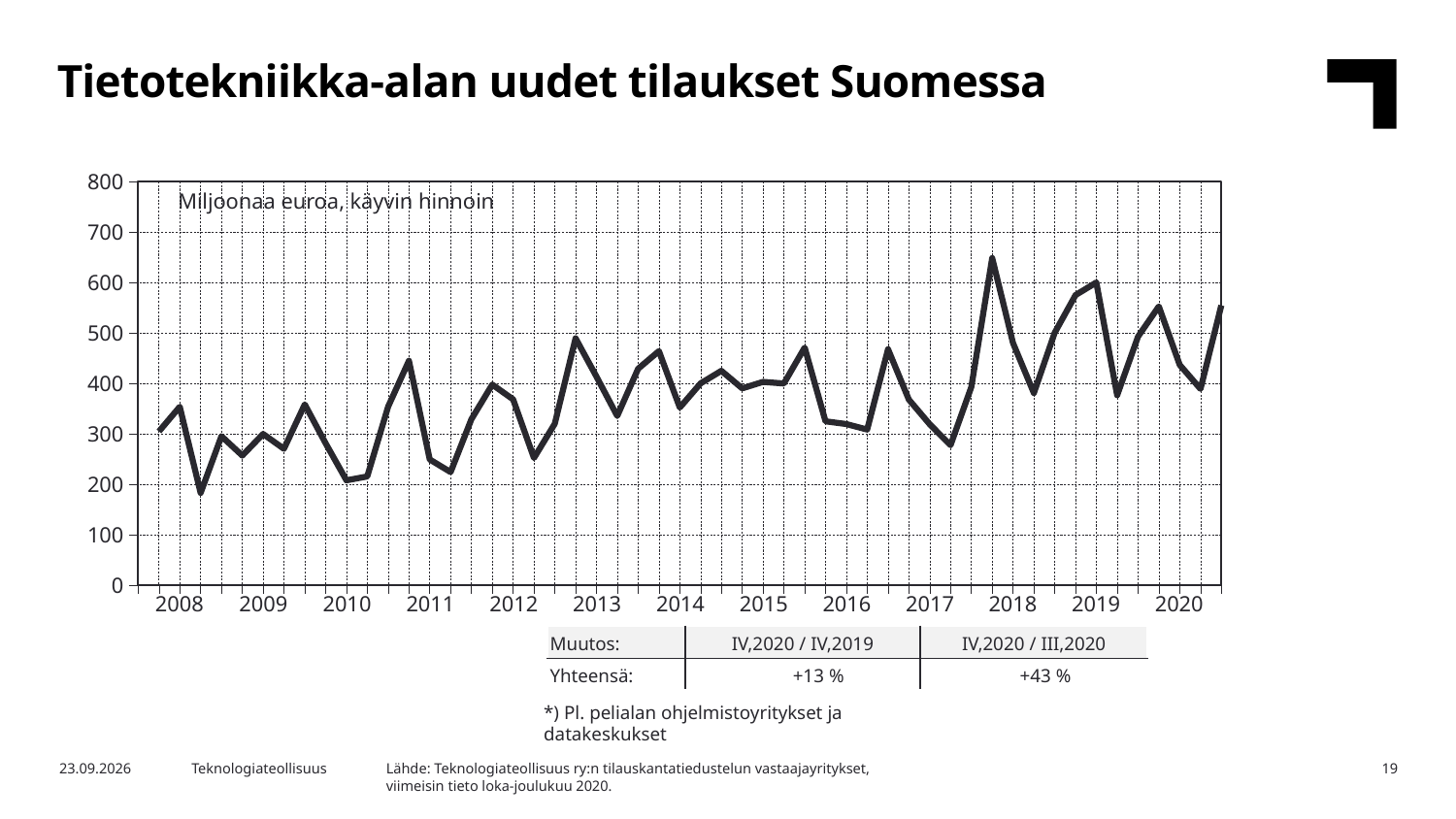
In which year does the line reach its highest point? 2018 Is the lowest value in 2010 greater or less than 300? less In which year does the line reach its lowest point? 2008 Is the peak value in 2018 greater or less than 600? greater How many years are labelled on the x axis? 13 Is the highest value in 2013 greater or less than 400? greater What kind of chart is shown on the slide? line chart What unit is stated inside the chart area? Miljoonaa euroa, käyvin hinnoin Is the peak in 2018 higher or lower than the peak in 2013? higher Overall, do the values rise or fall from 2008 to 2020? rise